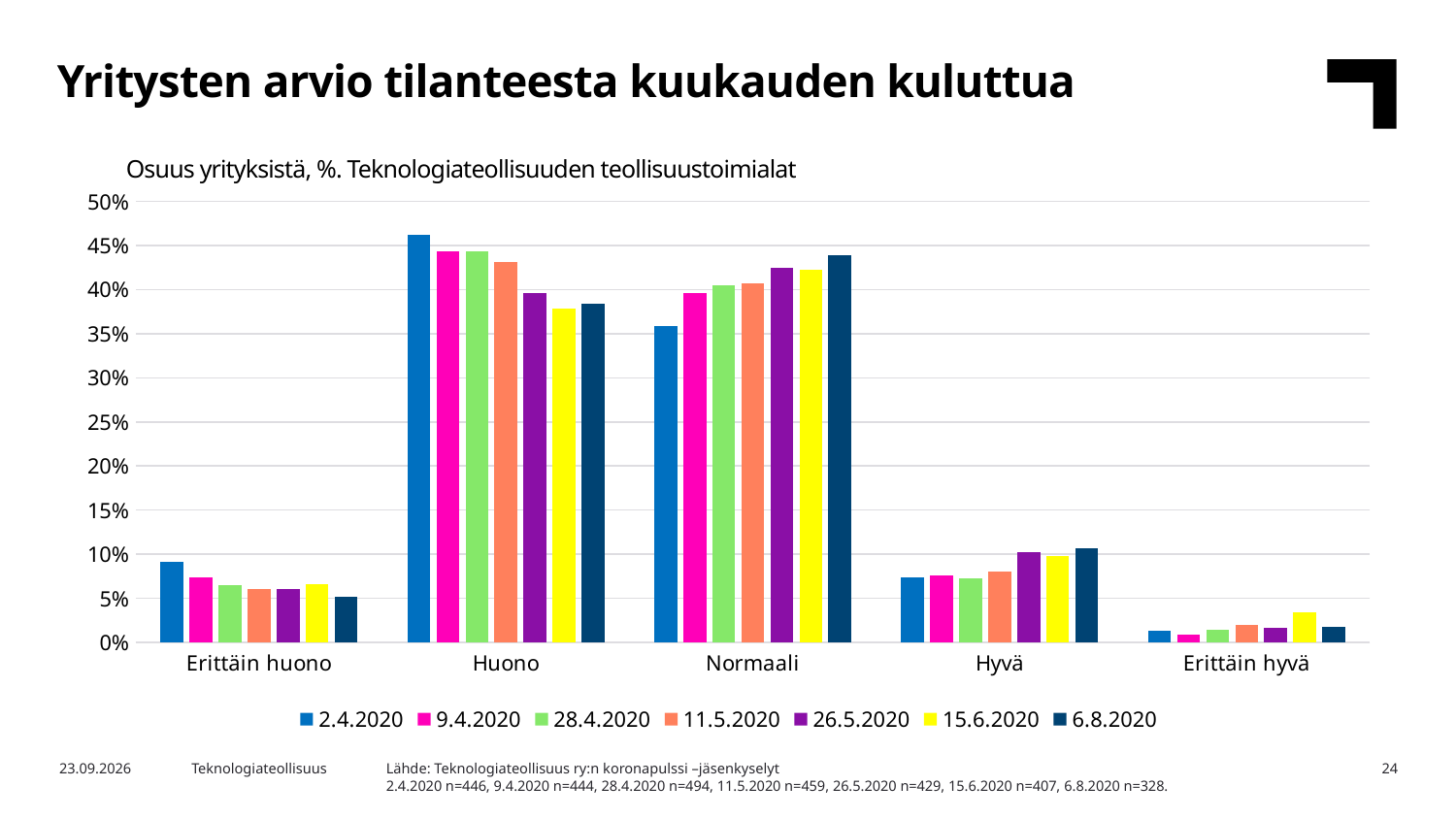
Is the value for Huono in the 2.4.2020 series greater or less than 40%? greater For Erittäin huono, which is larger: the 2.4.2020 value or the 6.8.2020 value? 2.4.2020 How many series does the legend list? 7 In the 15.6.2020 series, which is larger: Huono or Normaali? Normaali Is the value for Normaali in the 2.4.2020 series greater or less than 40%? less What kind of chart is shown on the slide? bar chart Which category has the highest value in the 6.8.2020 series? Normaali Which category has the highest value in the 2.4.2020 series? Huono Is the value for Hyvä in the 6.8.2020 series greater or less than 5%? greater How many categories are shown on the x axis of the chart? 5 Which category has the lowest value in the 6.8.2020 series? Erittäin hyvä